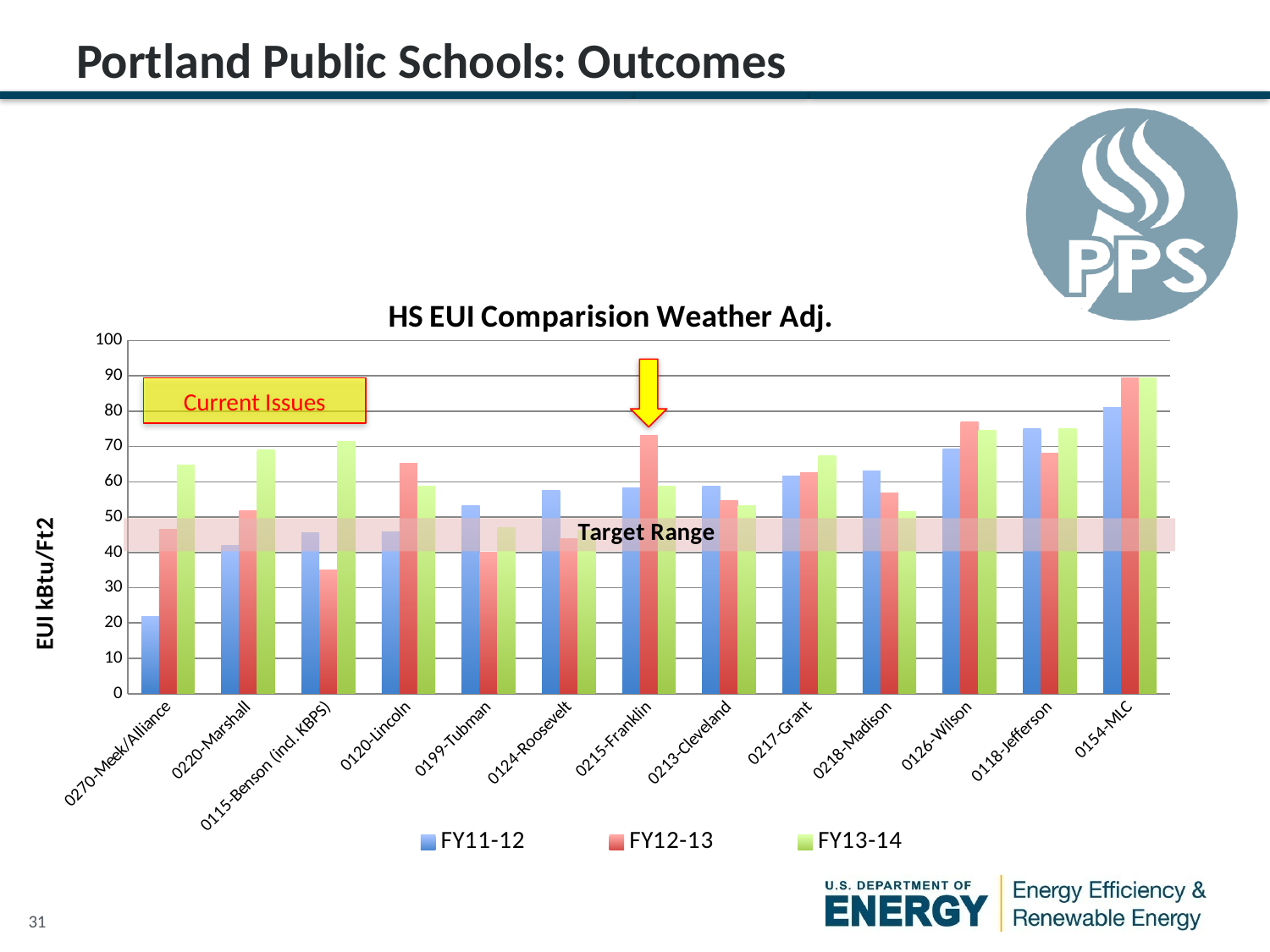
Which school has the lowest FY12-13 value? 0115-Benson (incl. KBPS) Is the FY12-13 value for 0215-Franklin greater or less than 70? greater Is the FY13-14 value for 0270-Meek/Alliance greater or less than 60? greater Which school has the lowest FY11-12 value? 0270-Meek/Alliance Is the FY11-12 value for 0270-Meek/Alliance greater or less than 30? less Which school has the highest FY11-12 value? 0154-MLC How many series does the legend list? 3 For 0220-Marshall, which is larger: the FY11-12 value or the FY13-14 value? FY13-14 What kind of chart is shown on the slide? bar chart How many schools are shown on the x axis? 13 For 0120-Lincoln, which is larger: the FY12-13 value or the FY13-14 value? FY12-13 What is the title of the chart? HS EUI Comparision Weather Adj.